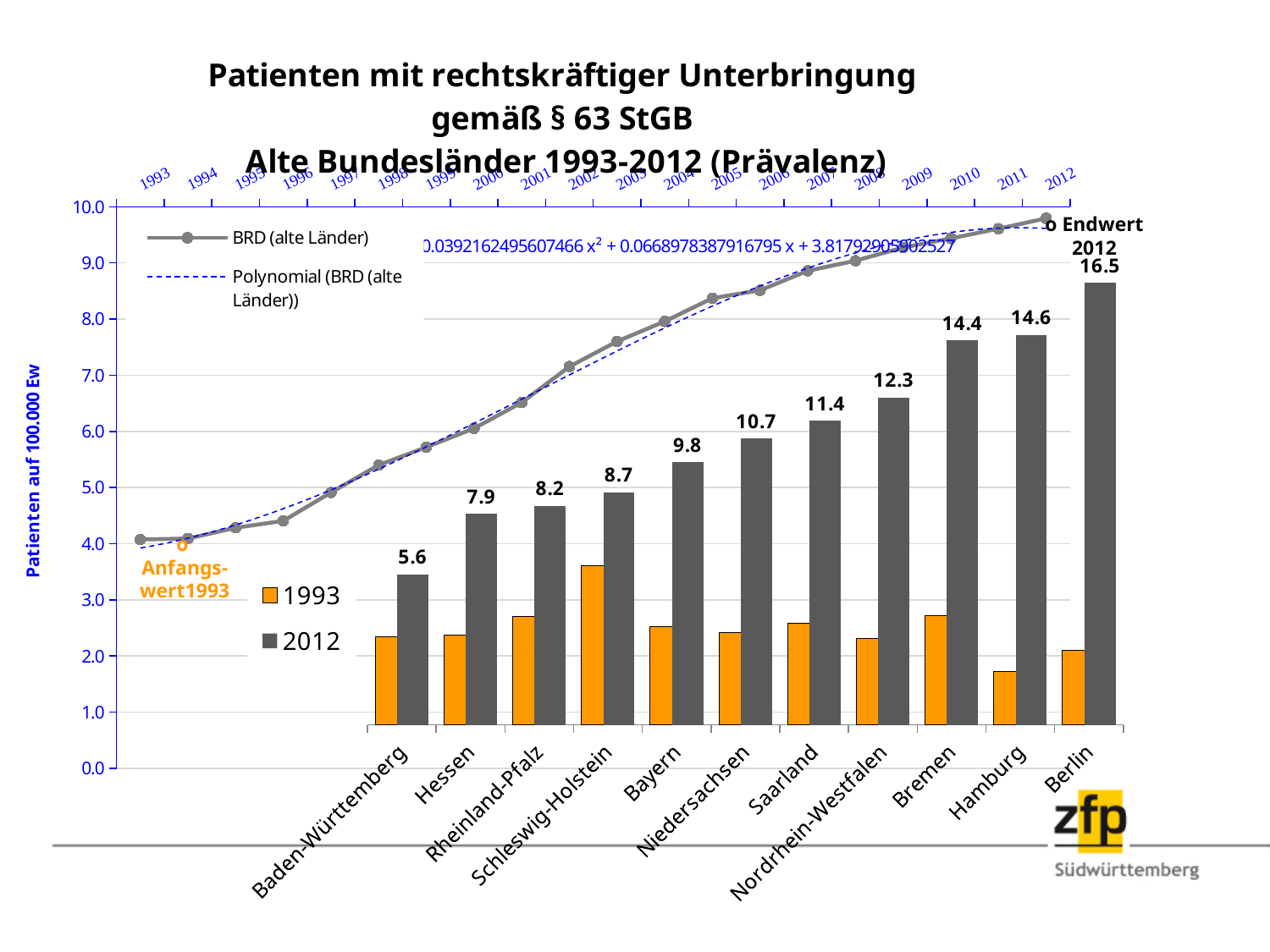
In the line chart for BRD (alte Länder), is the value for 2012 greater or less than 9.0? greater In the bar chart comparing 1993 and 2012 by Bundesland, what is the 2012 value for Nordrhein-Westfalen? 12.3 In the bar chart comparing 1993 and 2012 by Bundesland, what is the difference between the 2012 values for Berlin and Hamburg? 1.9 In the bar chart comparing 1993 and 2012 by Bundesland, which Bundesland has the highest 2012 value? Berlin In the bar chart comparing 1993 and 2012 by Bundesland, what is the 2012 value for Baden-Württemberg? 5.6 In the bar chart comparing 1993 and 2012 by Bundesland, what is the 2012 value for Bayern? 9.8 In the bar chart comparing 1993 and 2012 by Bundesland, which Bundesland has the lowest 2012 value? Baden-Württemberg In the bar chart comparing 1993 and 2012 by Bundesland, which has the larger 2012 value, Saarland or Niedersachsen? Saarland In the line chart for BRD (alte Länder), do the values rise or fall from 1993 to 2012? rise In the bar chart comparing 1993 and 2012 by Bundesland, how many series does the legend list? 2 In the bar chart comparing 1993 and 2012 by Bundesland, how many Bundesländer are shown? 11 What type of chart shows the BRD (alte Länder) series from 1993 to 2012? line chart